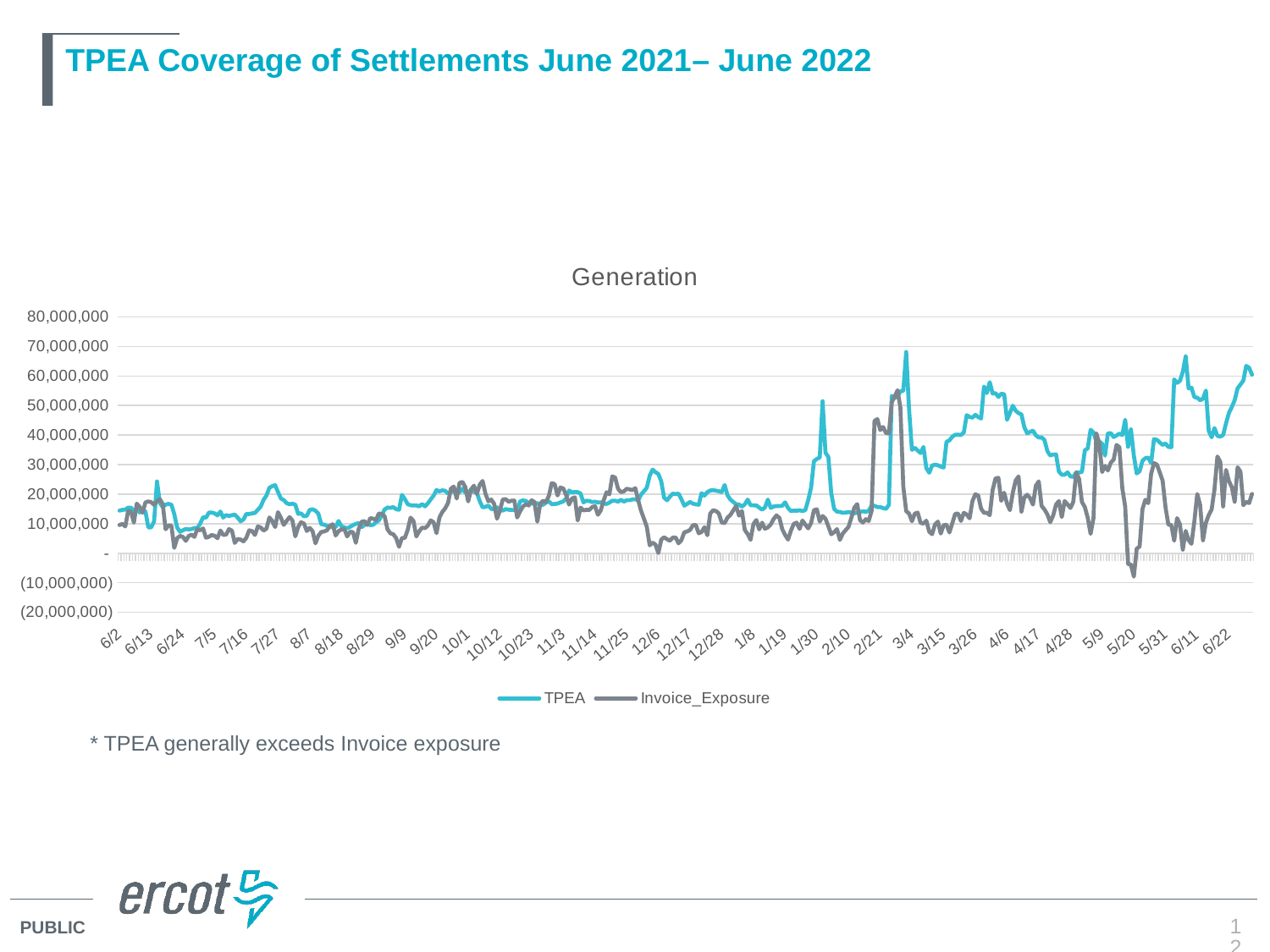
Which series reaches the highest value on the chart? TPEA Is the TPEA spike around 1/30 greater or less than 40,000,000? greater Which series reaches the lowest value on the chart? Invoice_Exposure Which two series are listed in the chart legend? TPEA and Invoice_Exposure Is the lowest value of Invoice_Exposure around 5/20 greater or less than 0? less Is the TPEA value at the start of the chart (6/2) greater or less than 20,000,000? less What kind of chart is shown on the slide? Line chart How many series does the legend of the chart list? 2 Does the TPEA series overall rise or fall from 6/2 to 6/22 along the x axis? rise What is the title of the chart? Generation Around 12/6, which series has the larger value, TPEA or Invoice_Exposure? TPEA